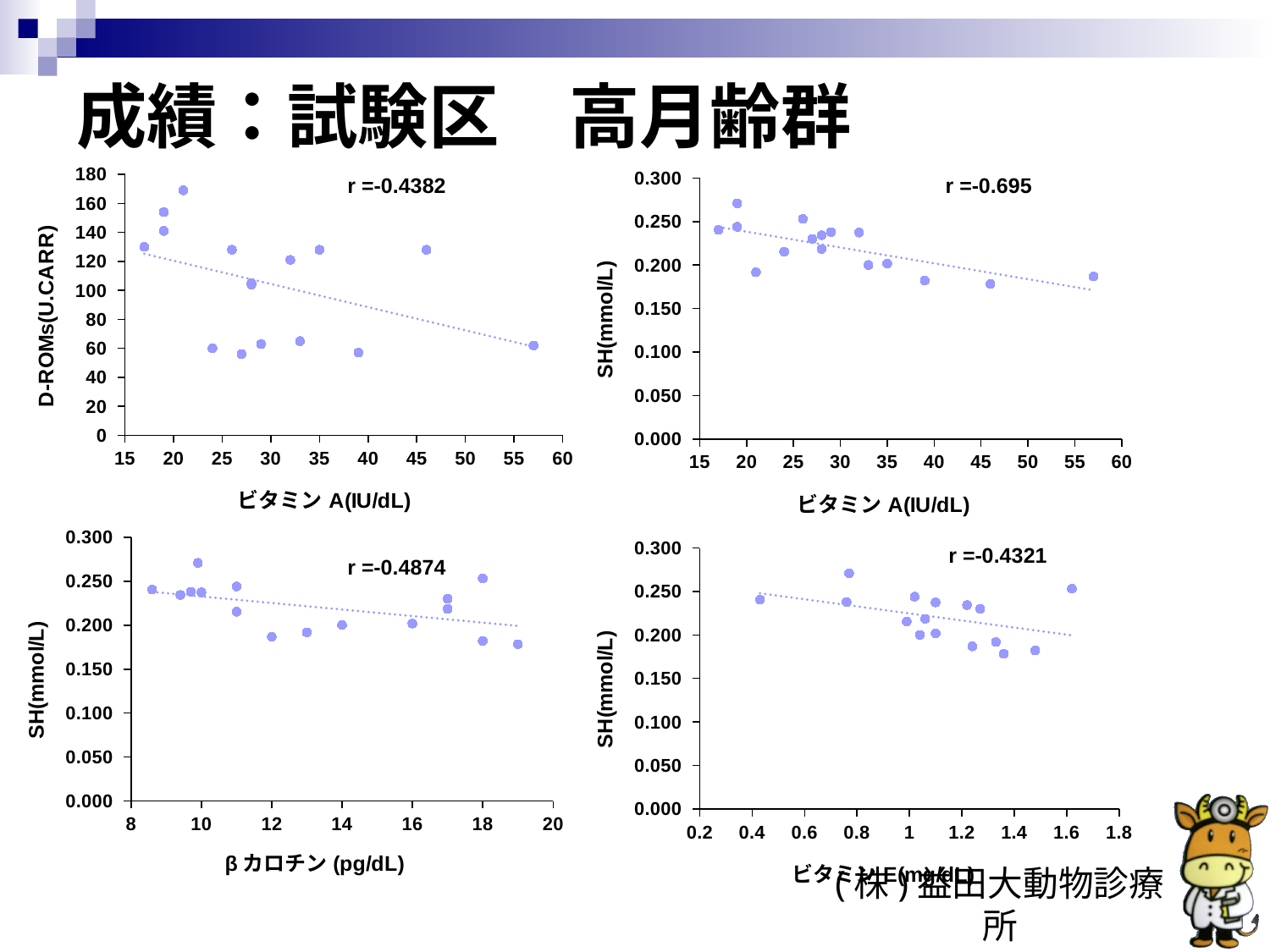
What is the x-axis label of the bottom-left chart? β カロチン (pg/dL) What is the y-axis label of the top-left chart? D-ROMs(U.CARR) In the top-right chart (SH vs ビタミン A), what correlation coefficient r is printed? r =-0.695 In the bottom-right chart, what correlation coefficient r is printed? r =-0.4321 What kind of chart is the top-left chart (D-ROMs vs ビタミン A)? scatter chart In the top-right chart (SH vs ビタミン A), is the SH value of the point at ビタミン A = 57 greater or less than 0.150? greater In the top-left chart (D-ROMs vs ビタミン A), is the D-ROMs value of the point at ビタミン A = 57 greater or less than 80? less In the top-left chart (D-ROMs vs ビタミン A), does the dotted trend line rise or fall as ビタミン A increases? fall In the top-left chart (D-ROMs vs ビタミン A), what correlation coefficient r is printed? r =-0.4382 How many charts are shown on the slide? 4 In the top-right chart (SH vs ビタミン A), does the dotted trend line rise or fall as ビタミン A increases? fall In the bottom-left chart (SH vs β カロチン), what correlation coefficient r is printed? r =-0.4874